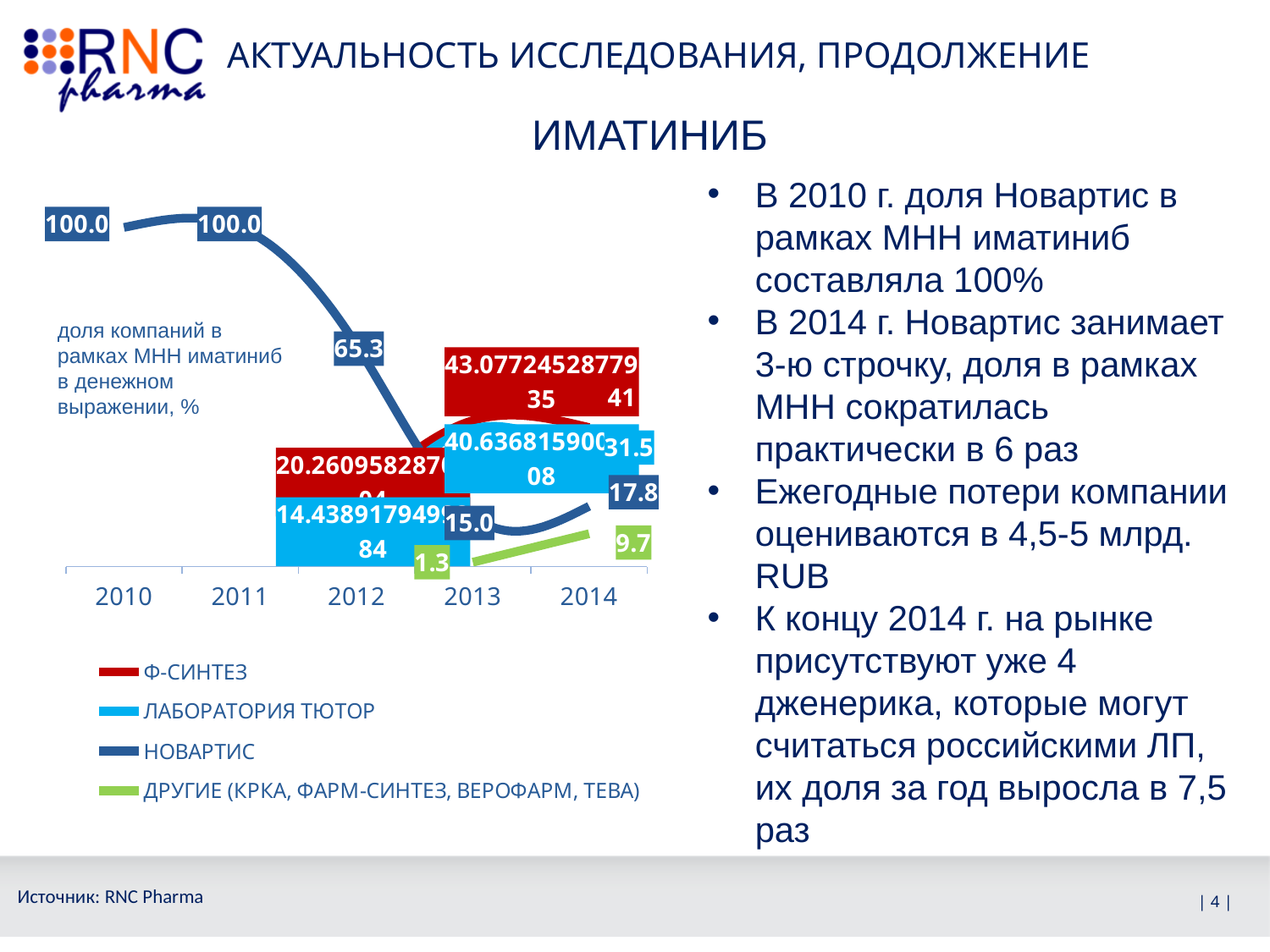
What is the value for НОВАРТИС in 2010? 100.0 How many years are shown on the x axis? 5 What type of chart is shown on the slide? line chart What is the value for НОВАРТИС in 2014? 17.8 What is the value for ЛАБОРАТОРИЯ ТЮТОР in 2014? 31.5 What is the difference between the НОВАРТИС values in 2012 and 2013? 50.3 What is the value for НОВАРТИС in 2012? 65.3 How many series does the legend list? 4 Which is larger in 2014: the value for НОВАРТИС or the value for ДРУГИЕ (КРКА, ФАРМ-СИНТЕЗ, ВЕРОФАРМ, ТЕВА)? НОВАРТИС What is the value for ДРУГИЕ (КРКА, ФАРМ-СИНТЕЗ, ВЕРОФАРМ, ТЕВА) in 2014? 9.7 In which year is the НОВАРТИС value lowest? 2013 Does the НОВАРТИС series rise or fall from 2011 to 2013? fall